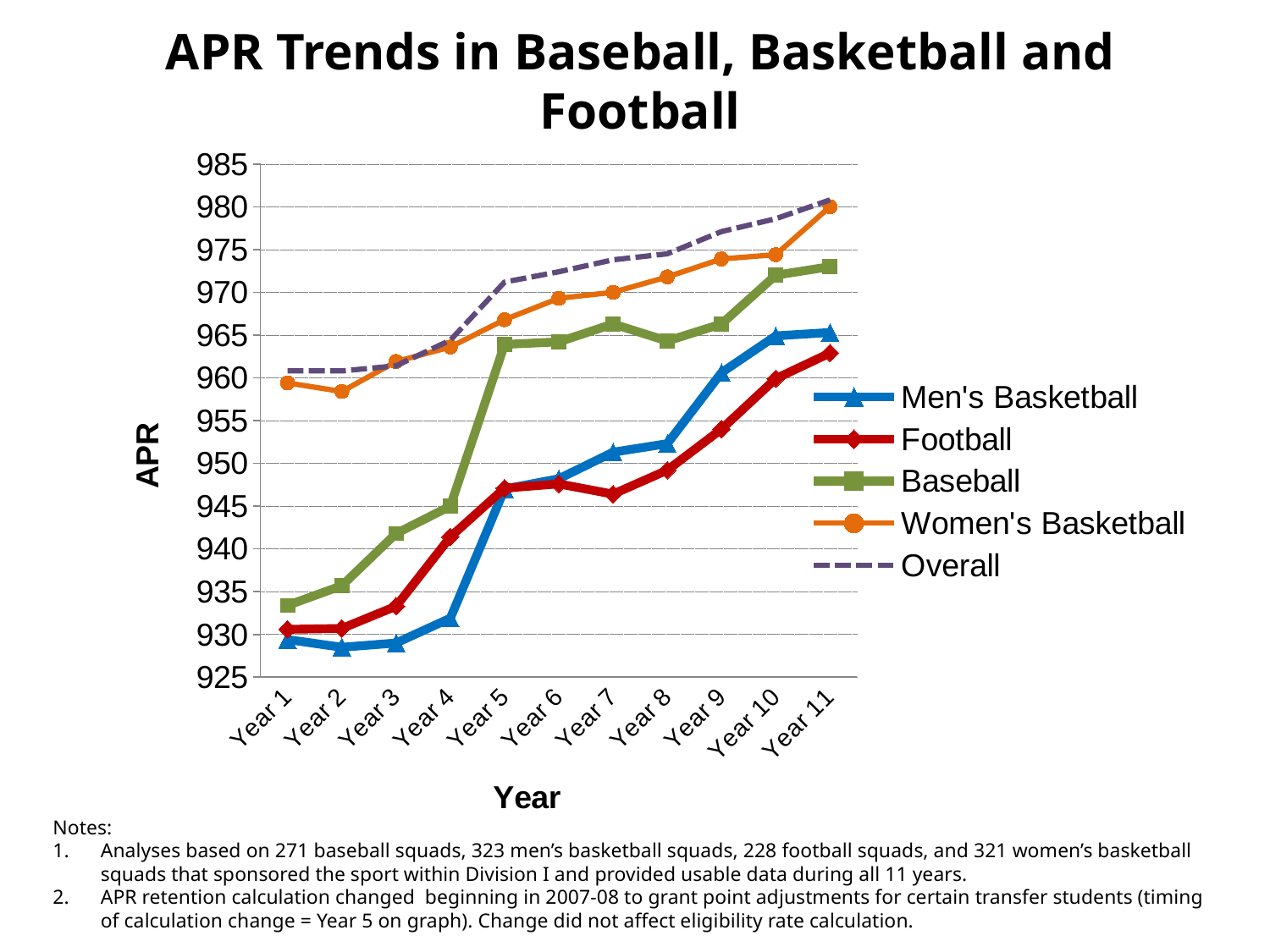
Is the value for Men's Basketball in Year 2 greater or less than 930? less Which series has the highest value in Year 5? Overall Is the value for Football in Year 11 greater or less than 960? greater What kind of chart is shown on the slide? line chart Is the value for Baseball in Year 1 greater or less than 935? less In Year 5, which is larger, the value for Baseball or the value for Football? Baseball How many series does the legend list? 5 How many years are plotted along the x axis? 11 Which series has the lowest value in Year 4? Men's Basketball Does the Men's Basketball line rise or fall overall from Year 1 to Year 11? rise In Year 7, which is larger, the value for Men's Basketball or the value for Football? Men's Basketball